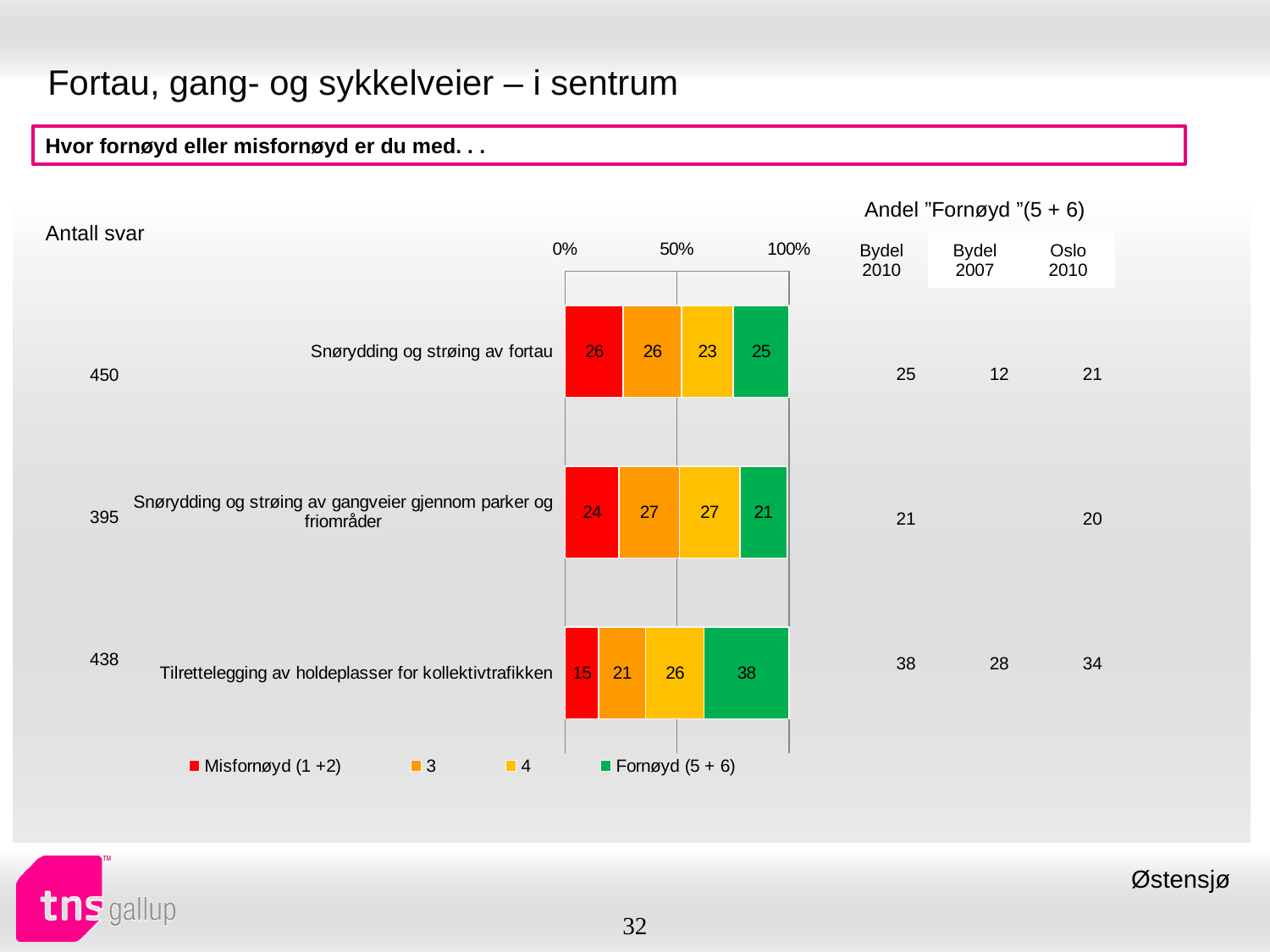
Which category has the lowest Misfornøyd (1 +2) value? Tilrettelegging av holdeplasser for kollektivtrafikken What is the value of the '3' segment for 'Snørydding og strøing av gangveier gjennom parker og friområder'? 27 What is the difference between the Fornøyd (5 + 6) values for 'Tilrettelegging av holdeplasser for kollektivtrafikken' and 'Snørydding og strøing av gangveier gjennom parker og friområder'? 17 What is the value of the Fornøyd (5 + 6) segment for 'Tilrettelegging av holdeplasser for kollektivtrafikken'? 38 How many categories are plotted in the chart? 3 What colour represents the Fornøyd (5 + 6) series in the legend? green Which is larger: the Misfornøyd (1 +2) value for 'Snørydding og strøing av fortau' or for 'Tilrettelegging av holdeplasser for kollektivtrafikken'? Snørydding og strøing av fortau How many series does the legend list? 4 What is the total of the stacked bar for 'Snørydding og strøing av gangveier gjennom parker og friområder'? 99 What is the value of the Misfornøyd (1 +2) segment for 'Snørydding og strøing av fortau'? 26 What kind of chart is shown on the slide? stacked bar chart Which category has the highest Fornøyd (5 + 6) value? Tilrettelegging av holdeplasser for kollektivtrafikken